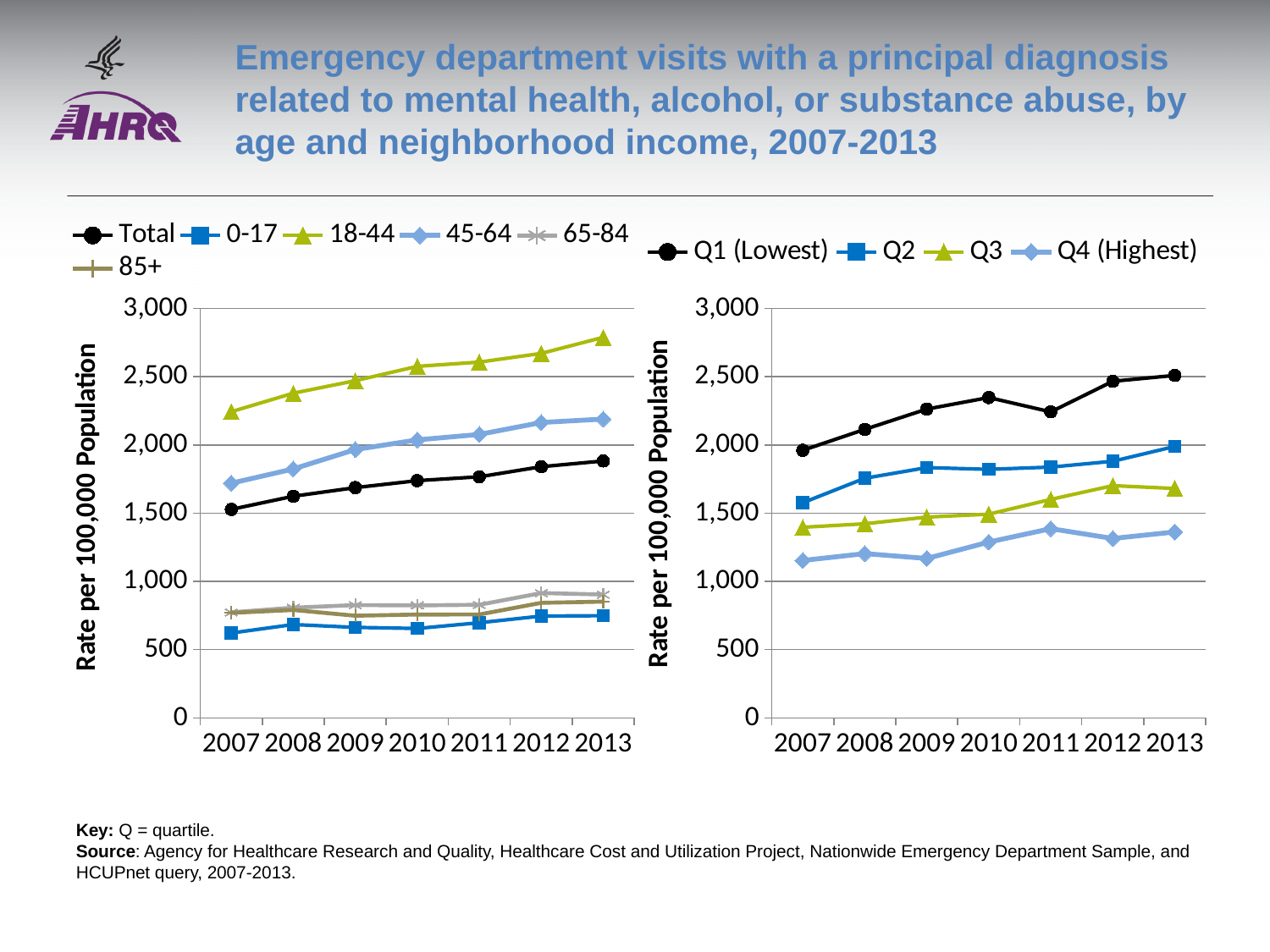
How many series does the legend of the right chart (by neighborhood income quartile) list? 4 In the right chart (by neighborhood income quartile), is the value for Q3 in 2013 greater or less than 1,500? greater In the right chart (by neighborhood income quartile), does the Q1 (Lowest) rate generally rise or fall from 2007 to 2013? rise In the left chart (by age group), is the value for 18-44 in 2013 greater or less than 2,500? greater In the left chart (by age group), which age group has the lowest rate in 2007? 0-17 In the right chart (by neighborhood income quartile), which quartile has the highest rate in 2013? Q1 (Lowest) In the right chart (by neighborhood income quartile), which quartile has the lowest rate in 2007? Q4 (Highest) How many years are plotted along the x axis of the right chart (by neighborhood income quartile)? 7 In the left chart (by age group), which age group has the highest rate in 2013? 18-44 What kind of chart is the left chart (by age group)? line chart In the left chart (by age group), is the value for Total in 2007 greater or less than 2,000? less How many series does the legend of the left chart (by age group) list? 6